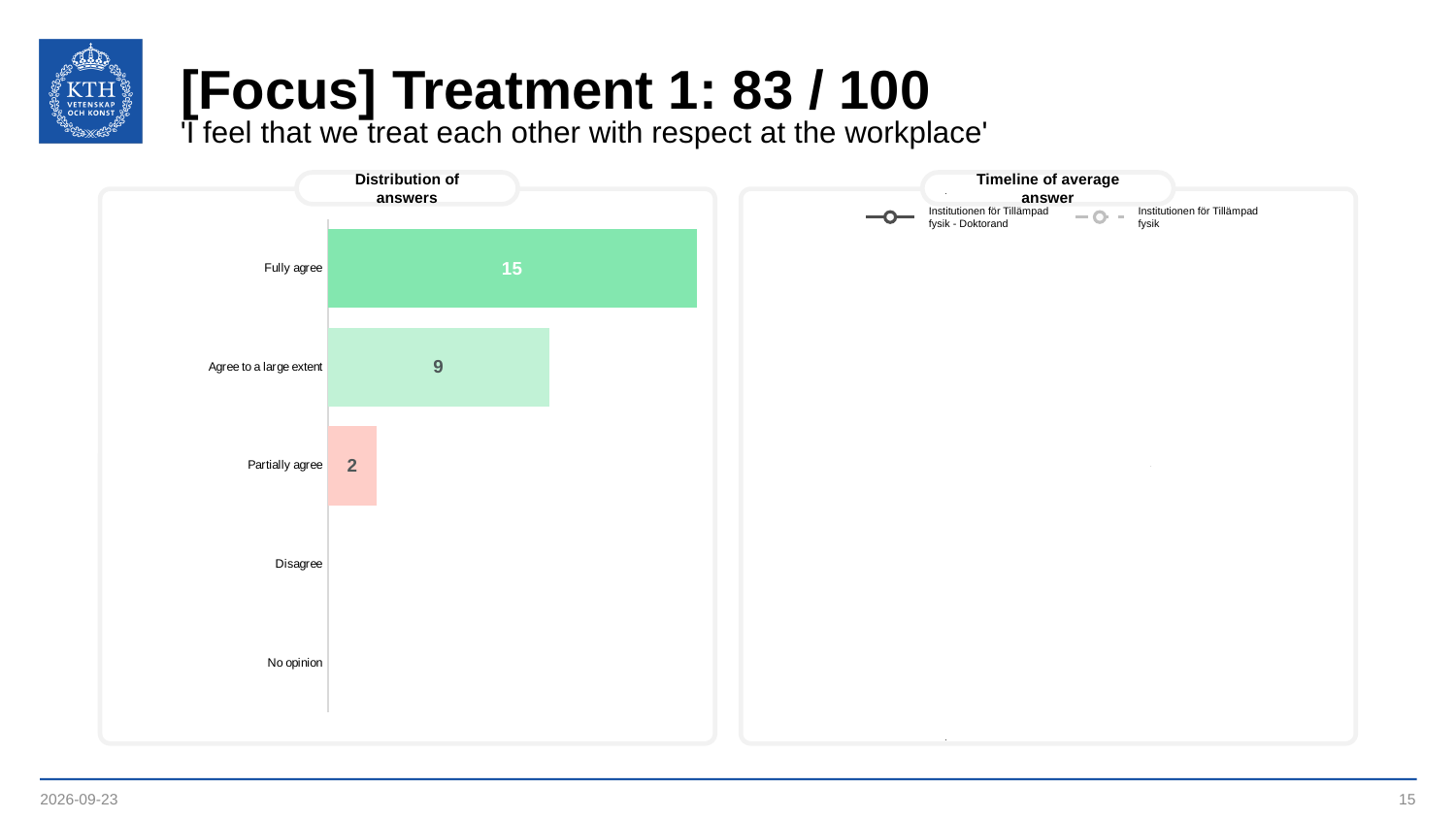
In the 'Distribution of answers' chart, what is the value for 'Agree to a large extent'? 9 What is the title of the chart on the left side of the slide? Distribution of answers In the 'Distribution of answers' chart, what is the value for 'Partially agree'? 2 In the 'Distribution of answers' chart, which answer category has the highest value? Fully agree How many series does the legend of the 'Timeline of average answer' chart list? 2 In the 'Distribution of answers' chart, which is larger: 'Agree to a large extent' or 'Partially agree'? Agree to a large extent What kind of chart is the 'Distribution of answers' chart? Bar chart How many answer categories are listed on the y axis of the 'Distribution of answers' chart? 5 In the 'Distribution of answers' chart, what is the difference between 'Agree to a large extent' and 'Partially agree'? 7 In the 'Distribution of answers' chart, how many respondents chose 'Fully agree'? 15 In the 'Distribution of answers' chart, what colour is the 'Partially agree' bar? Light red/pink In the 'Distribution of answers' chart, what is the difference between the 'Fully agree' and 'Agree to a large extent' values? 6